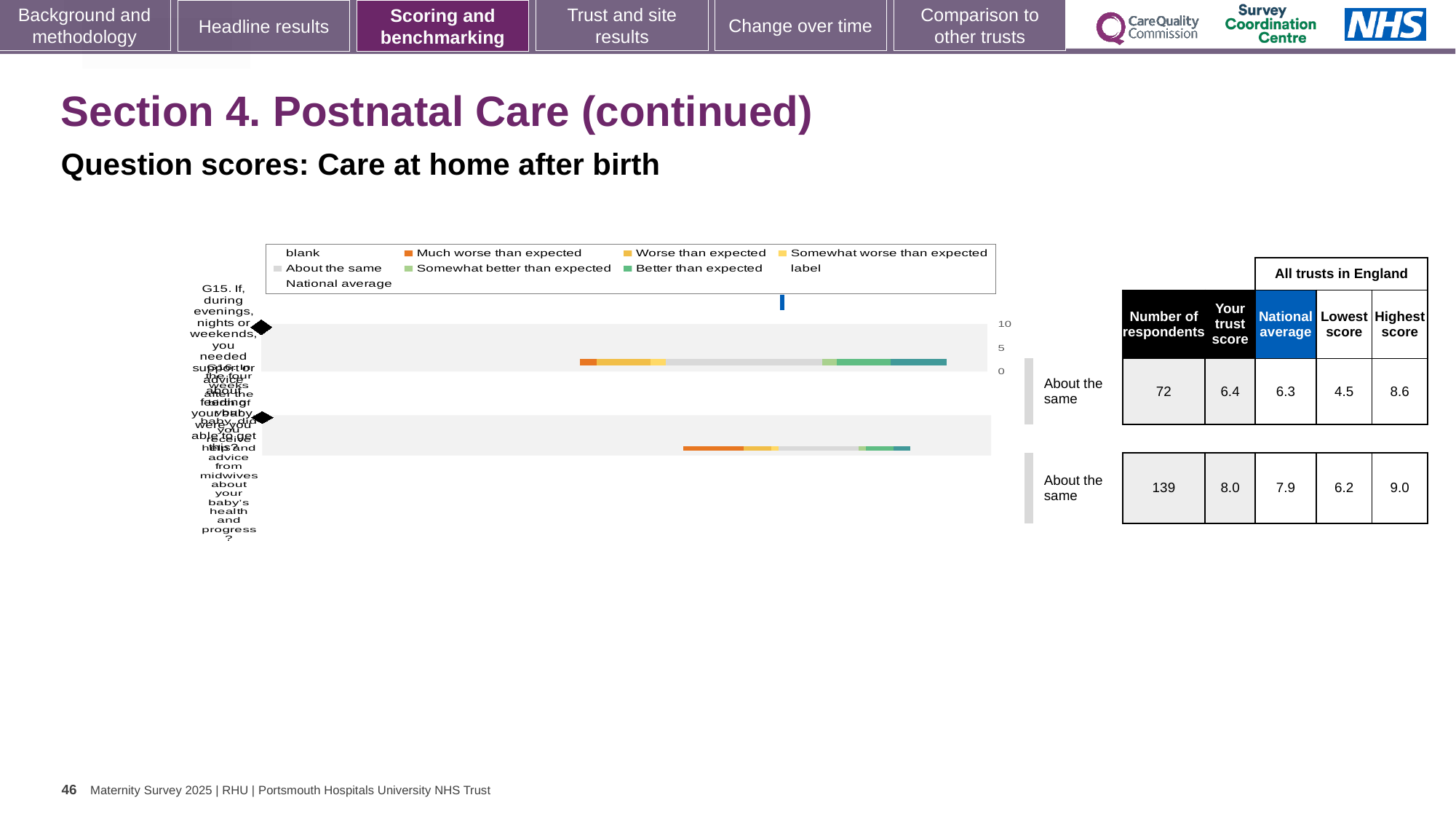
In the table beside the chart, what is 'Your trust score' for the second question row? 8.0 What are the tick values shown on the chart's numeric axis? 0, 5, 10 What colour does the legend use for 'Much worse than expected'? orange In the table beside the chart, how many respondents are listed for the first question row? 72 In the table beside the chart, what is the difference between the highest score and the lowest score for the first question row? 4.1 How many entries does the chart legend list? 9 What kind of chart is shown on the slide? bar chart In the table beside the chart, what benchmark category is given for both question rows? About the same In the table beside the chart, which question row has the higher 'Your trust score', the first or the second? the second How many bars (question rows) are plotted in the chart? 2 In the table beside the chart, what is the lowest score for the second question row? 6.2 In the table beside the chart, what is the national average for the first question row? 6.3